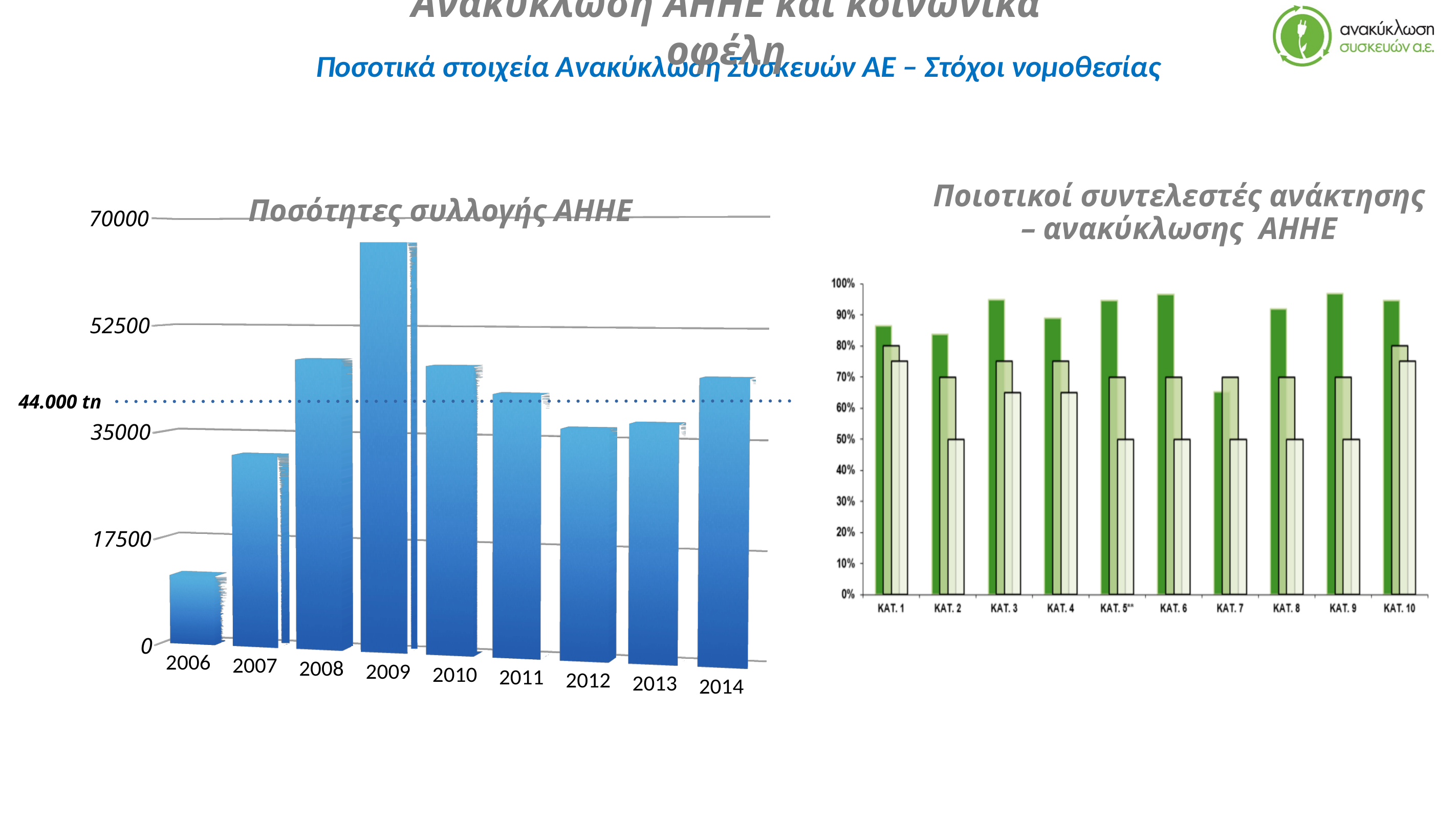
In the right chart 'Ποιοτικοί συντελεστές ανάκτησης – ανακύκλωσης ΑΗΗΕ', how many categories (ΚΑΤ.) are shown on the x axis? 10 In the left chart 'Ποσότητες συλλογής ΑΗΗΕ', how many years are shown on the x axis? 9 In the left chart 'Ποσότητες συλλογής ΑΗΗΕ', which year has the lowest bar? 2006 In the left chart 'Ποσότητες συλλογής ΑΗΗΕ', what value is labelled on the dotted horizontal reference line? 44.000 tn In the left chart 'Ποσότητες συλλογής ΑΗΗΕ', is the value for 2009 greater or less than 52500? greater In the left chart 'Ποσότητες συλλογής ΑΗΗΕ', is the value for 2008 greater or less than 35000? greater In the left chart 'Ποσότητες συλλογής ΑΗΗΕ', do the values rise or fall from 2006 to 2009? rise What type of chart is the left chart titled 'Ποσότητες συλλογής ΑΗΗΕ'? bar chart In the left chart 'Ποσότητες συλλογής ΑΗΗΕ', is the value for 2006 greater or less than 17500? less In the left chart 'Ποσότητες συλλογής ΑΗΗΕ', which year has the highest bar? 2009 In the left chart 'Ποσότητες συλλογής ΑΗΗΕ', which year has the larger value, 2007 or 2013? 2013